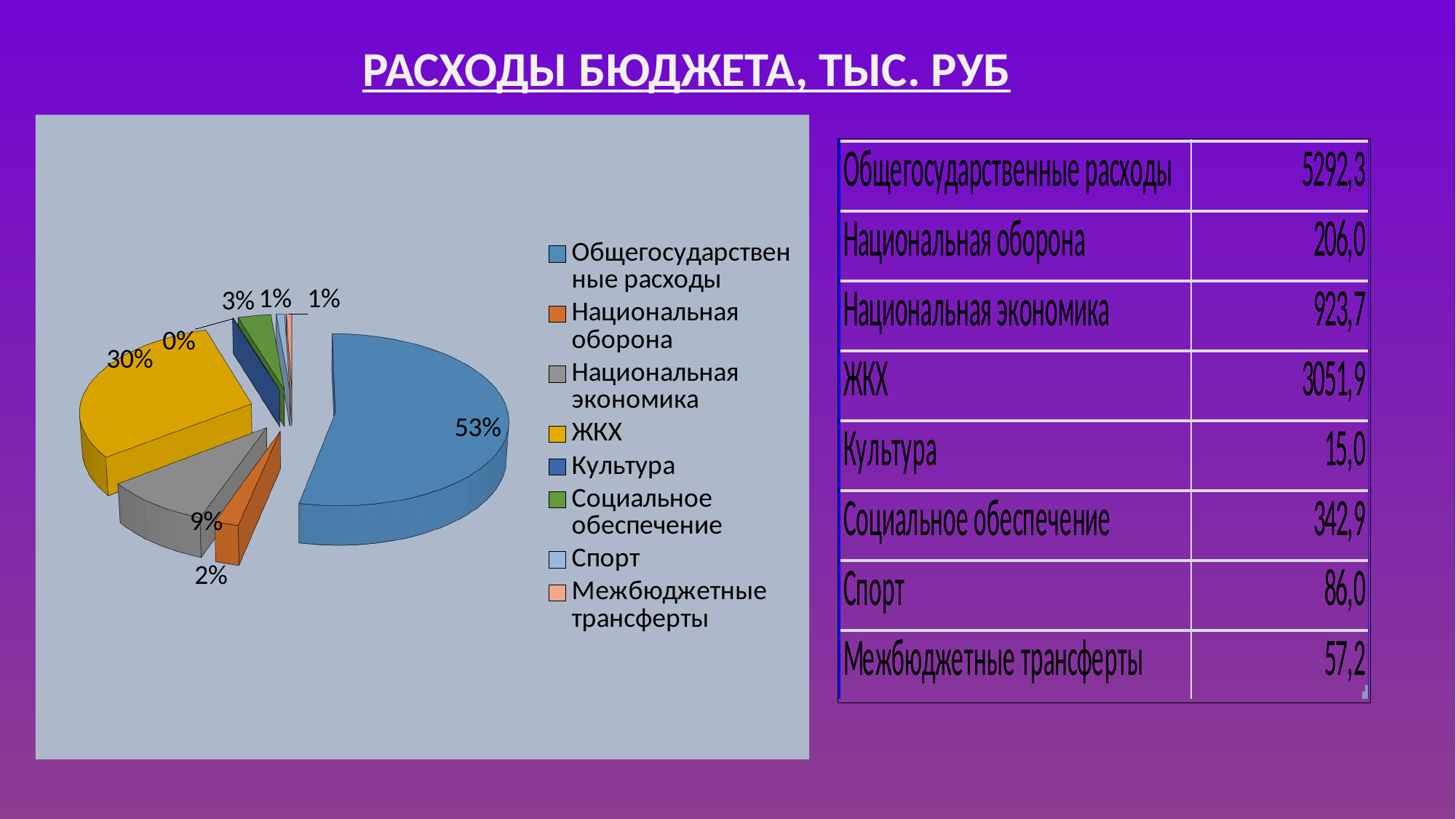
What is the title of the slide above the chart? РАСХОДЫ БЮДЖЕТА, ТЫС. РУБ How many entries does the legend of the pie chart list? 8 What share of the pie chart does ЖКХ take? 30% What percentage is shown for Общегосударственные расходы in the pie chart? 53% Which category has the smallest slice in the pie chart? Культура What percentage is shown for Социальное обеспечение in the pie chart? 3% What percentage is shown for Национальная оборона in the pie chart? 2% Which category has the largest slice in the pie chart? Общегосударственные расходы By how many percentage points does the Общегосударственные расходы slice exceed the ЖКХ slice? 23 Which slice is larger in the pie chart: ЖКХ or Национальная экономика? ЖКХ What kind of chart is shown on the slide? pie chart How many categories (slices) does the pie chart have? 8